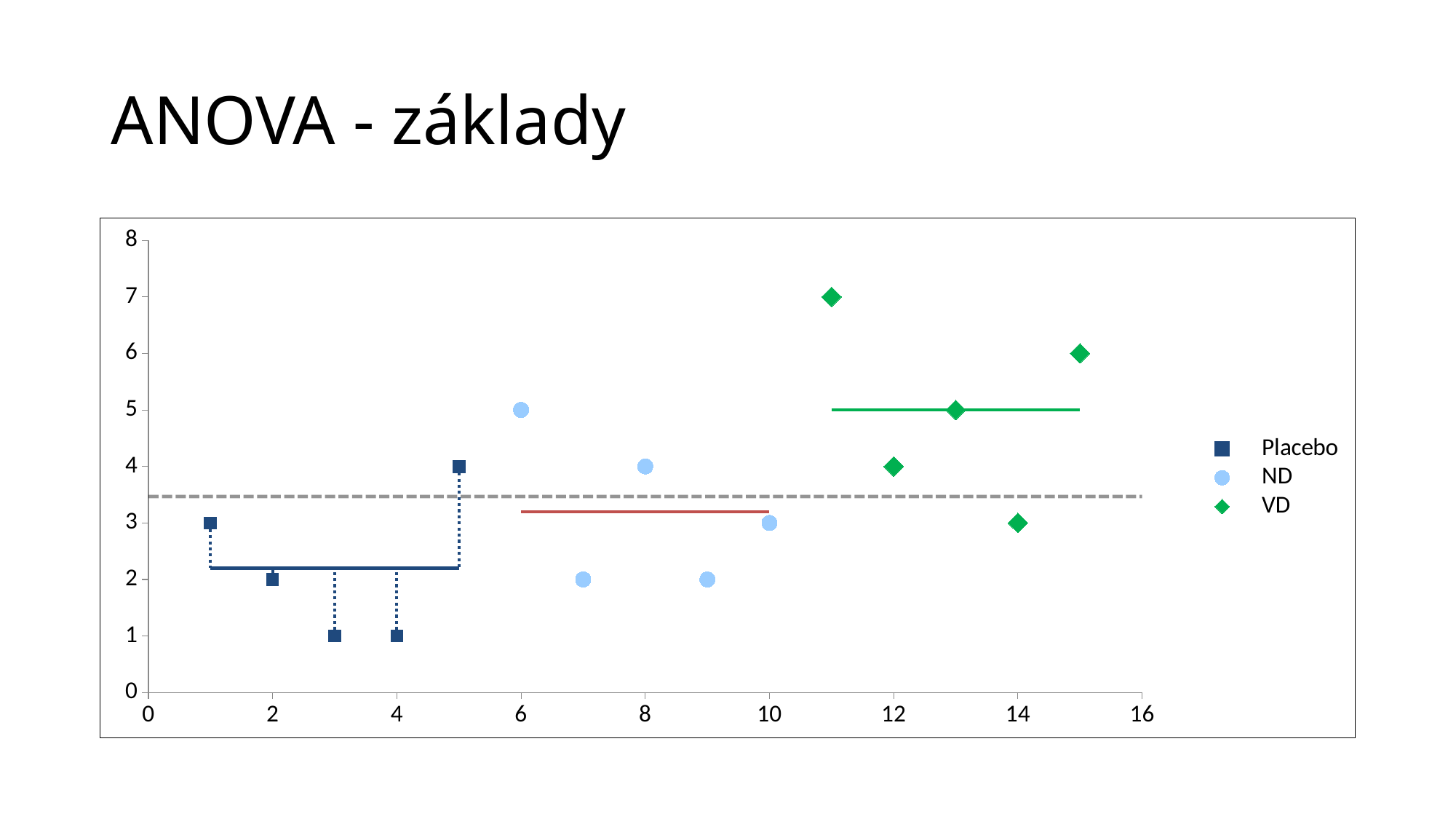
Which is larger: the y value of the ND point at x = 8 or the VD point at x = 14? ND point at x = 8 Which series contains the highest plotted point? VD Which series is shown with green diamond markers? VD Is the y value of the VD point at x = 15 greater or less than 5? greater What is the difference between the y value of the VD point at x = 11 and the Placebo point at x = 3? 6 What is the y value of the Placebo point at x = 5? 4 How many Placebo points are plotted? 5 What is the lowest y value among the Placebo points? 1 What is the y value of the ND point at x = 6? 5 What kind of chart is shown on the slide? scatter chart What is the y value of the VD point at x = 11? 7 How many series does the legend list? 3